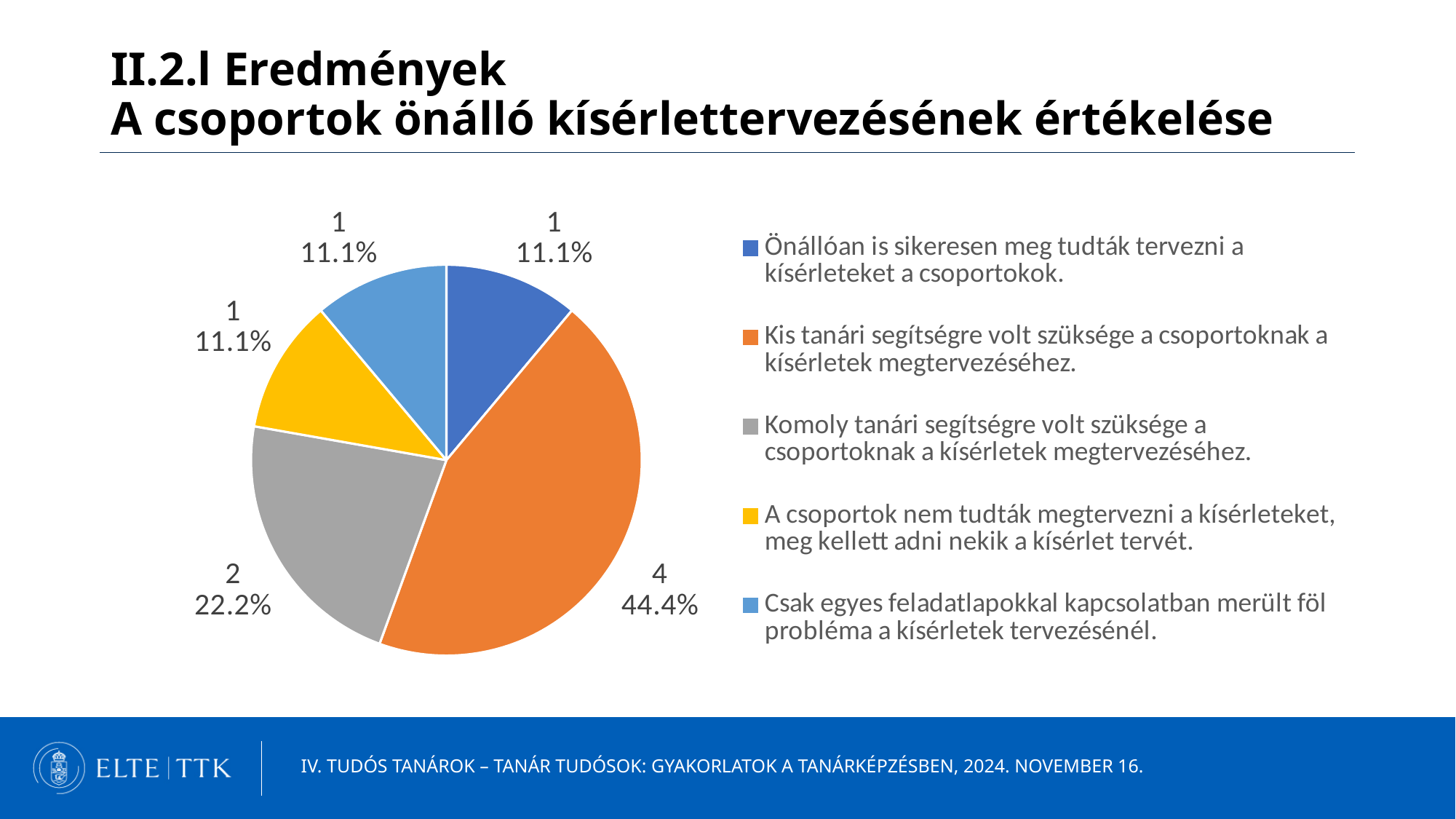
What count is shown for the slice 'Önállóan is sikeresen meg tudták tervezni a kísérleteket a csoportokok.'? 1 Which category has the largest share of the pie chart? Kis tanári segítségre volt szüksége a csoportoknak a kísérletek megtervezéséhez. What percentage share is shown for the slice 'Kis tanári segítségre volt szüksége a csoportoknak a kísérletek megtervezéséhez.'? 44.4% What is the total of the counts shown on all slices of the pie chart? 9 What is the difference in percentage points between the 44.4% slice and the 22.2% slice? 22.2% What count is shown for the slice 'Komoly tanári segítségre volt szüksége a csoportoknak a kísérletek megtervezéséhez.'? 2 What percentage share is shown for the slice 'Komoly tanári segítségre volt szüksége a csoportoknak a kísérletek megtervezéséhez.'? 22.2% What kind of chart is shown on the slide? Pie chart What percentage share is shown for the slice 'A csoportok nem tudták megtervezni a kísérleteket, meg kellett adni nekik a kísérlet tervét.'? 11.1% How many entries does the legend of the pie chart list? 5 How many slices does the pie chart have? 5 Which is larger: the share for 'Kis tanári segítségre volt szüksége a csoportoknak a kísérletek megtervezéséhez.' or the share for 'Komoly tanári segítségre volt szüksége a csoportoknak a kísérletek megtervezéséhez.'? Kis tanári segítségre volt szüksége a csoportoknak a kísérletek megtervezéséhez.